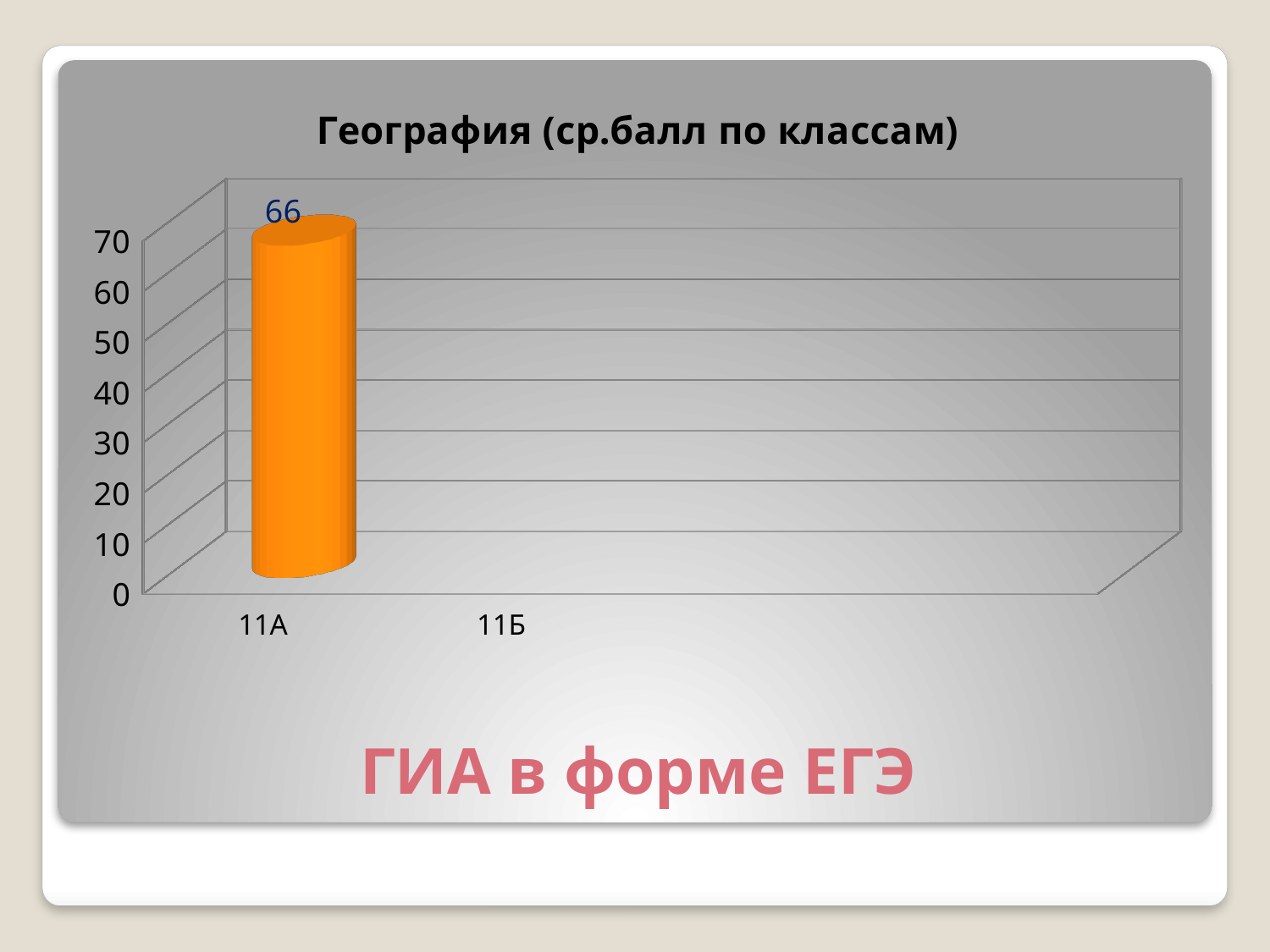
What is the title of the chart? География (ср.балл по классам) How many categories are labelled on the x axis? 2 What kind of chart is shown on the slide? bar chart Is the value for 11А greater or less than 70? less Is the value for 11А greater or less than 60? greater What is the value shown for 11А? 66 Which category has no bar plotted? 11Б Which category has the highest value? 11А What is the highest tick value shown on the vertical axis? 70